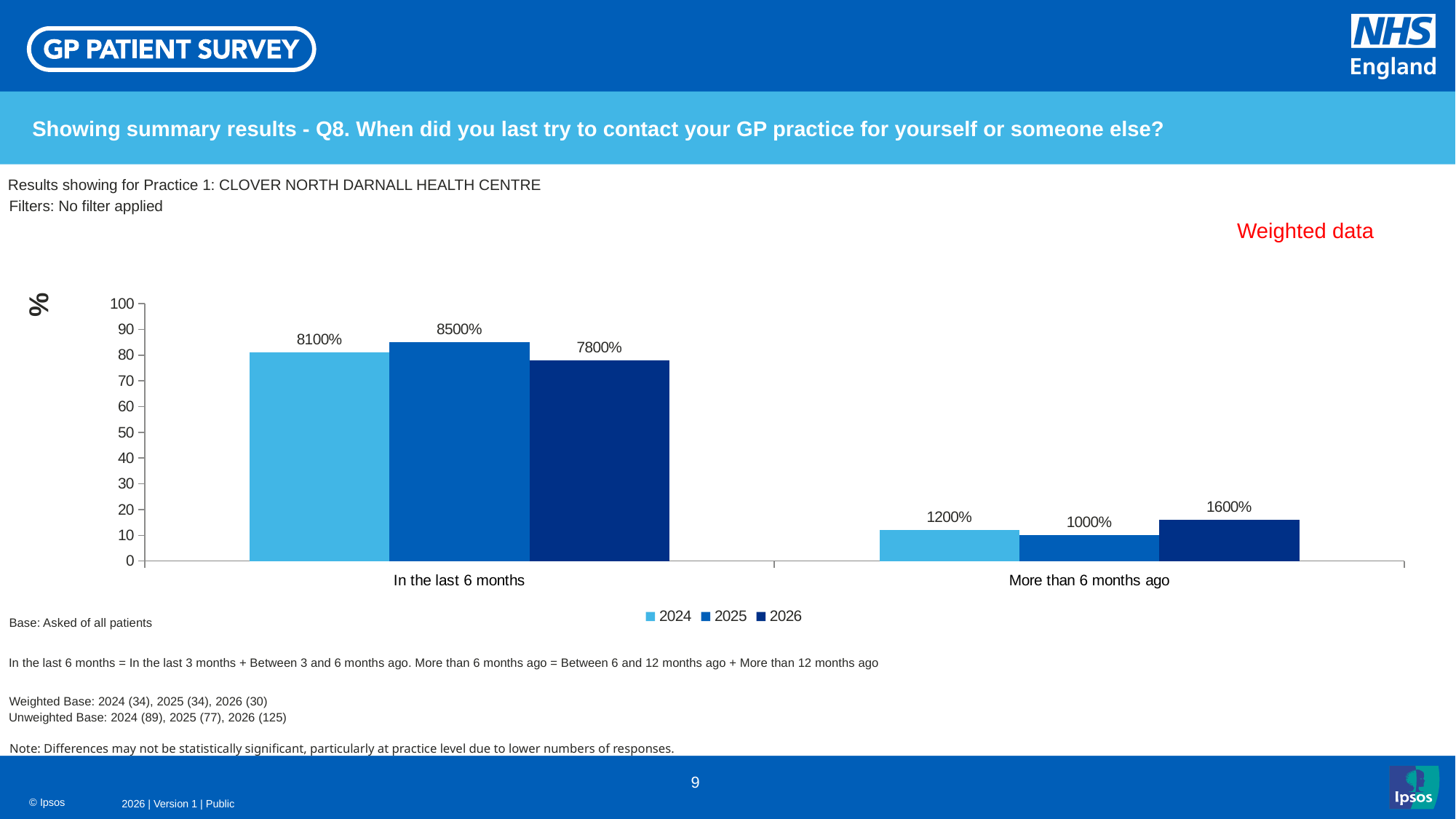
Which year has the highest value in the 'In the last 6 months' category? 2025 Which is larger in the 'In the last 6 months' category: the value for 2024 or the value for 2026? 2024 What is the value for 2025 in the 'More than 6 months ago' category? 1000% What is the value for 2025 in the 'In the last 6 months' category? 8500% What is the value for 2024 in the 'In the last 6 months' category? 8100% What is the value for 2026 in the 'More than 6 months ago' category? 1600% Which year has the lowest value in the 'More than 6 months ago' category? 2025 Which practice are the results shown for? CLOVER NORTH DARNALL HEALTH CENTRE What kind of chart is shown on the slide? bar chart How many series does the legend list? 3 Is the value for 2026 in the 'In the last 6 months' category greater or less than 80 on the axis? less How many categories are shown on the x axis? 2